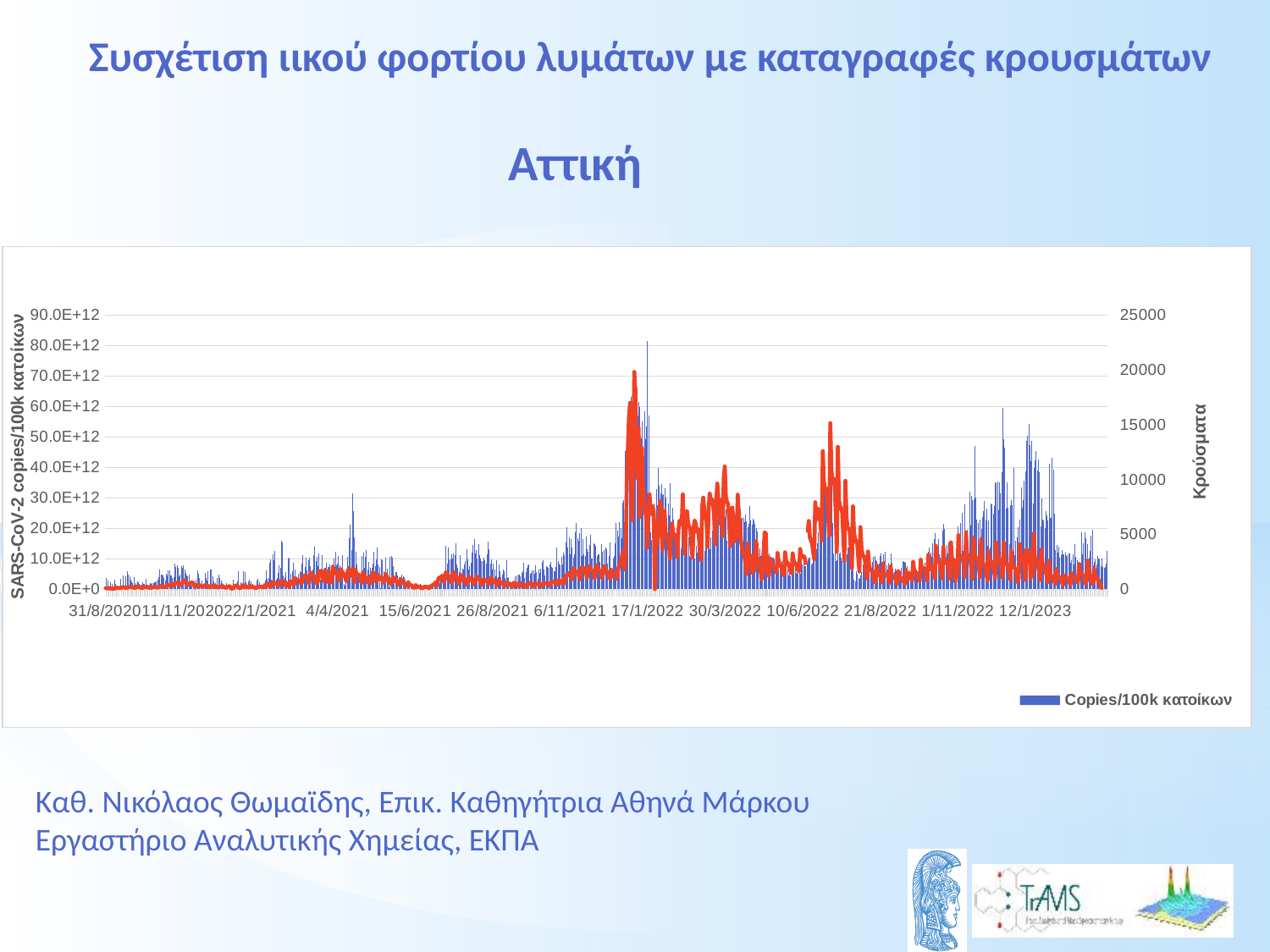
Is the tallest blue bar near 12/1/2023 greater or less than 40.0E+12 on the left axis? greater Is the tallest blue bar near 4/4/2021 greater or less than 20.0E+12 on the left axis? greater Is the peak of the red line between 10/6/2022 and 21/8/2022 greater or less than 10000 on the right axis? greater What kind of chart is shown on the slide? A bar chart with a line overlay What is the series name shown in the chart's legend? Copies/100k κατοίκων Which is taller: the highest blue bar around 17/1/2022 or the highest blue bar around 12/1/2023? The one around 17/1/2022 How many series does the chart's legend list? 1 What is the title of the right-hand vertical axis? Κρούσματα How many date labels are shown along the x axis? 13